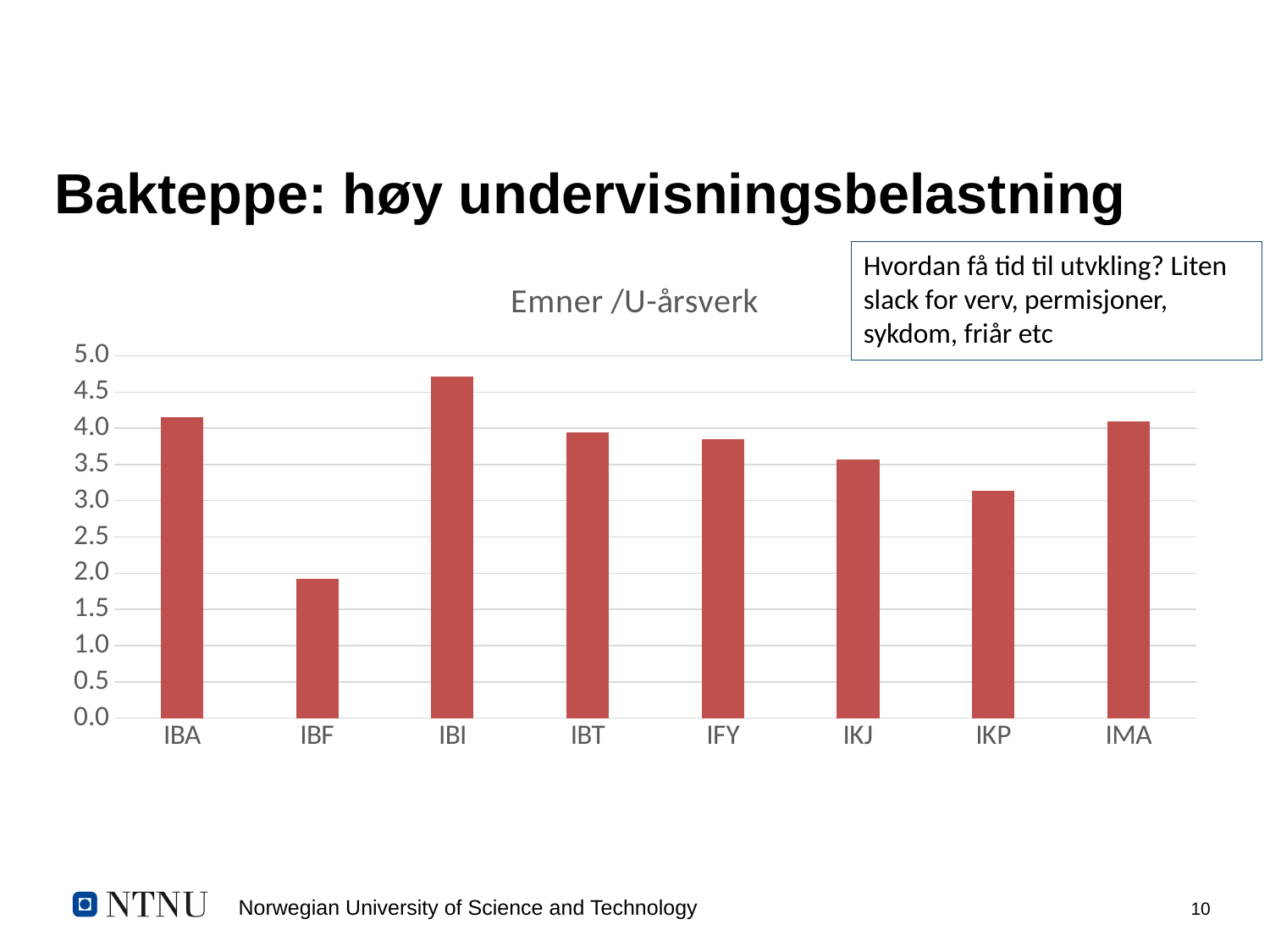
Is the value for IKJ greater or less than 4.0? less Is the value for IBF greater or less than 2.0? less Is the value for IKP greater or less than 3.0? greater Which category has the lowest value in the chart? IBF Which has a larger value, IKJ or IMA? IMA Which has a larger value, IKP or IBA? IBA What is the title of the chart? Emner /U-årsverk Which has a larger value, IBI or IBF? IBI Which category has the highest value in the chart? IBI What kind of chart is shown on the slide? bar chart How many categories are shown on the x axis of the chart? 8